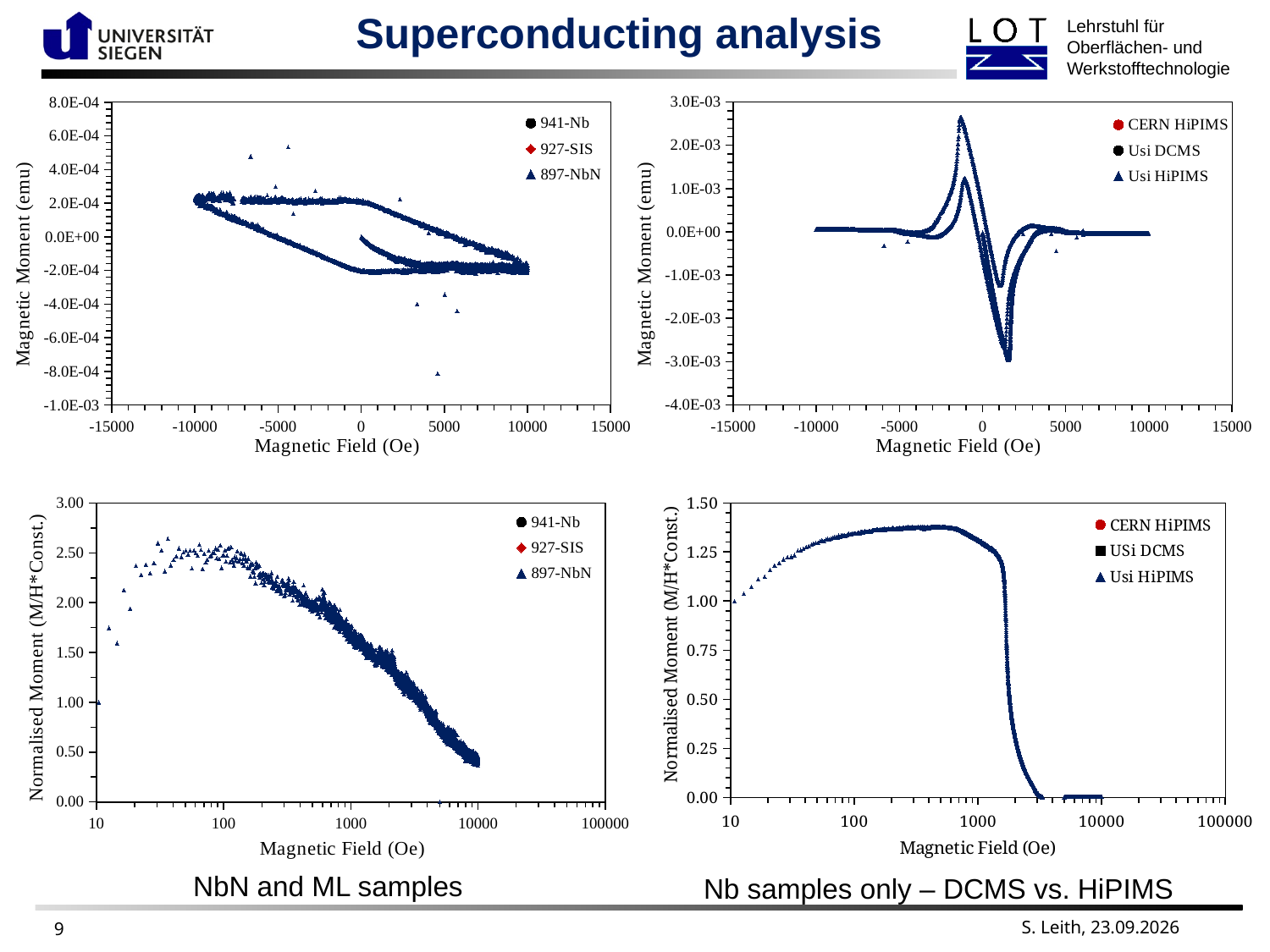
In the bottom-left chart, is the normalised moment at a magnetic field of 100 Oe greater or less than 2.00? greater In the bottom-right chart, does the normalised moment rise or fall as the magnetic field increases from 1000 Oe to 10000 Oe? fall What is the x-axis label of the top-right chart? Magnetic Field (Oe) In the bottom-right chart, is the normalised moment at a magnetic field of 10000 Oe greater or less than 0.25? less How many series does the legend of the top-left chart list? 3 What kind of chart is the top-left chart on the slide? scatter chart How many series does the legend of the bottom-right chart list? 3 In the top-right chart, is the lowest magnetic moment reached by the plotted data greater or less than -2.0E-03 emu? less What is the y-axis label of the bottom-left chart? Normalised Moment (M/H*Const.)